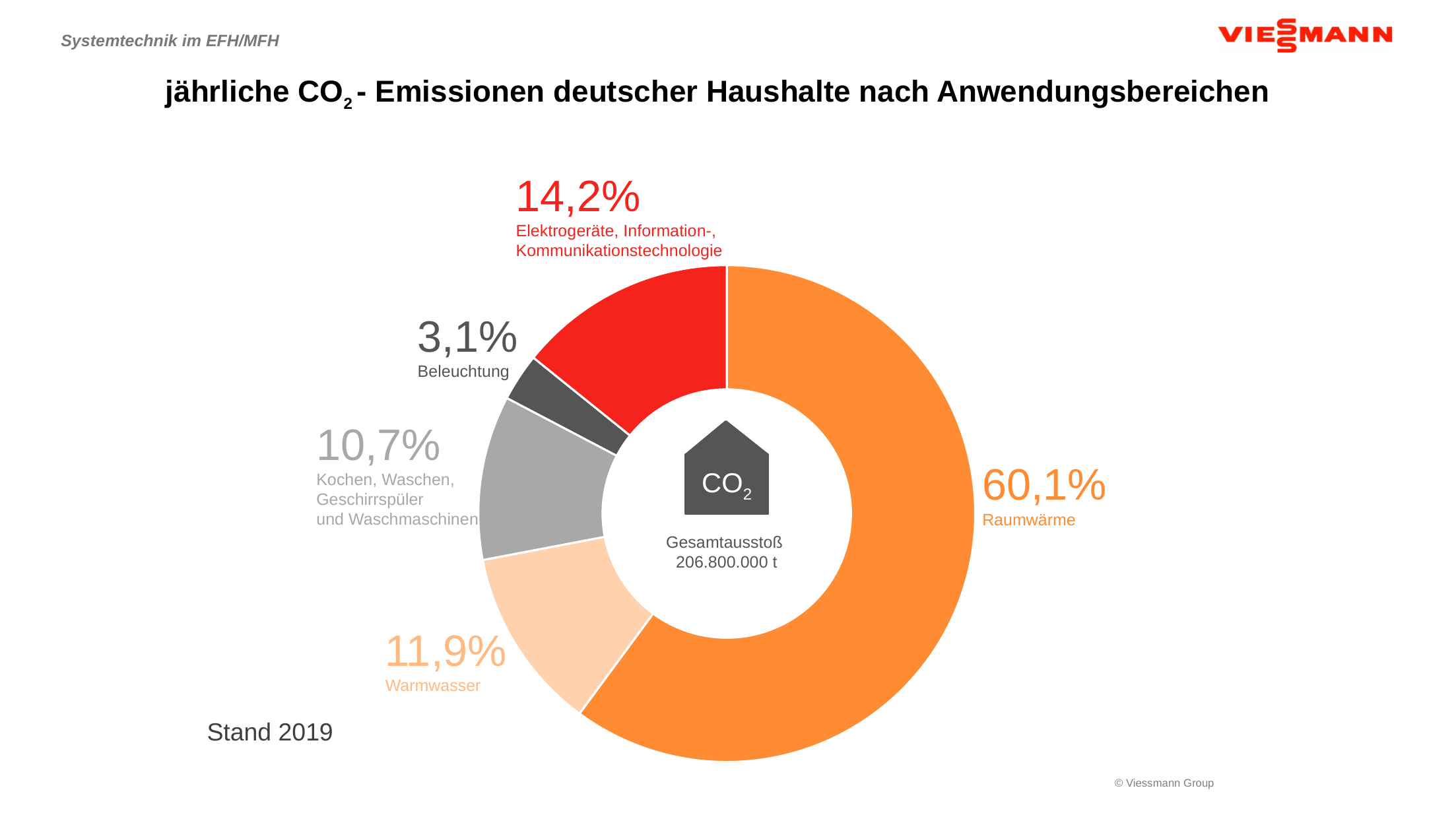
What kind of chart is shown on the slide? Pie chart (donut) What total emission figure (Gesamtausstoß) is shown in the centre of the chart? 206.800.000 t What is the difference in percentage points between Raumwärme and Warmwasser? 48,2 What share is given for Kochen, Waschen, Geschirrspüler und Waschmaschinen? 10,7% Which application area has the smallest share of emissions? Beleuchtung Which application area has the largest share of emissions? Raumwärme What is the share for Beleuchtung? 3,1% What percentage is shown for Elektrogeräte, Information-, Kommunikationstechnologie? 14,2% What percentage does the Warmwasser slice represent? 11,9% Which is larger, the share for Warmwasser or the share for Kochen, Waschen, Geschirrspüler und Waschmaschinen? Warmwasser What share of annual CO2 emissions is attributed to Raumwärme? 60,1% How many slices does the chart have? 5